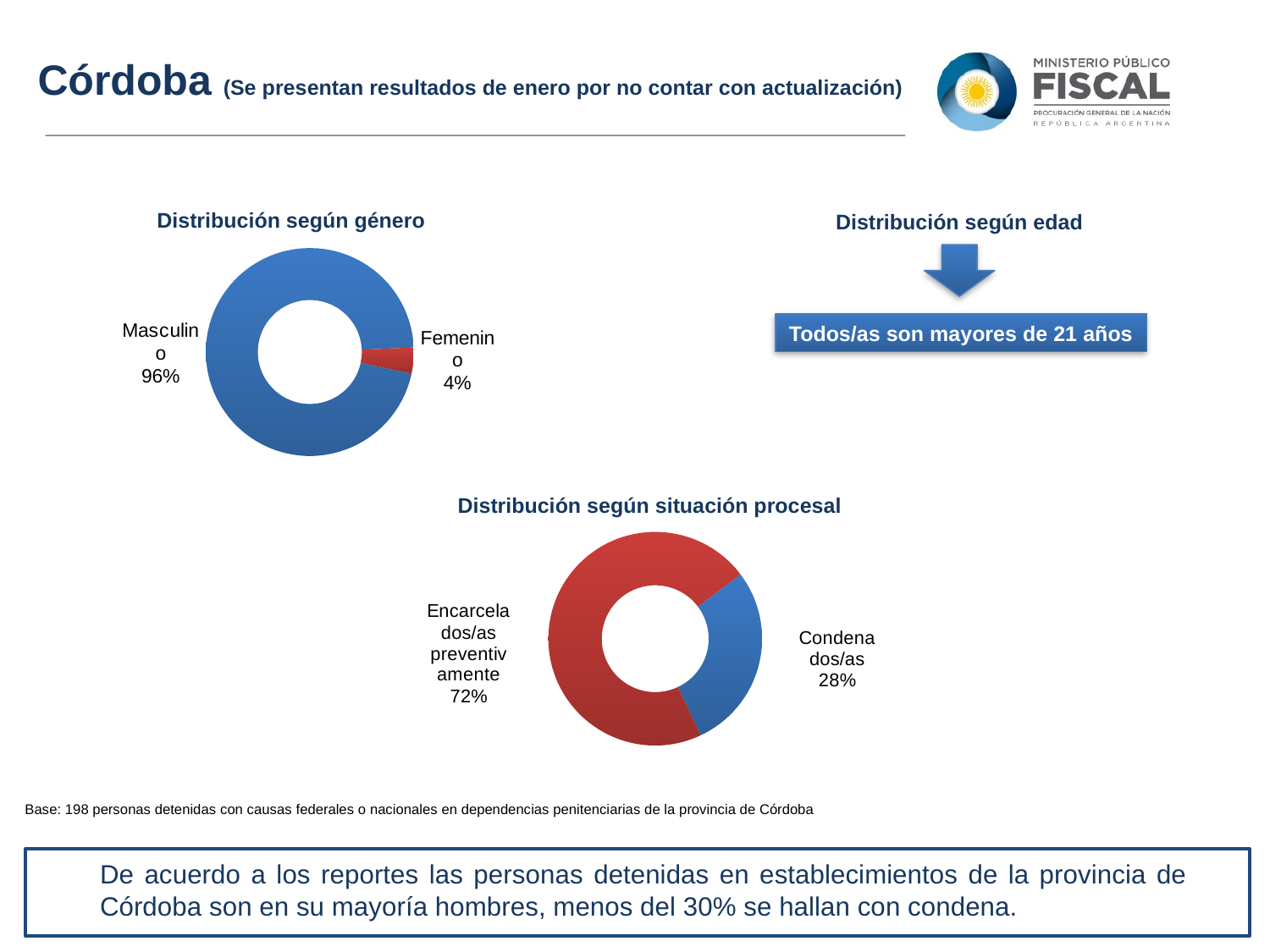
In the 'Distribución según situación procesal' chart, which category has the smallest share? Condenados/as In the 'Distribución según situación procesal' chart, what share is Condenados/as? 28% In the 'Distribución según género' chart, what is the difference in percentage points between Masculino and Femenino? 92 In the 'Distribución según situación procesal' chart, which is larger: Encarcelados/as preventivamente or Condenados/as? Encarcelados/as preventivamente In the 'Distribución según género' chart, which category has the largest share? Masculino How many categories does the 'Distribución según género' chart show? 2 In the 'Distribución según situación procesal' chart, what is the difference in percentage points between Encarcelados/as preventivamente and Condenados/as? 44 In the 'Distribución según situación procesal' chart, what colour is the Condenados/as slice? Blue In the 'Distribución según género' chart, what share is Masculino? 96% In the 'Distribución según situación procesal' chart, what share is Encarcelados/as preventivamente? 72% What kind of chart is 'Distribución según género'? Doughnut chart In the 'Distribución según género' chart, what share is Femenino? 4%